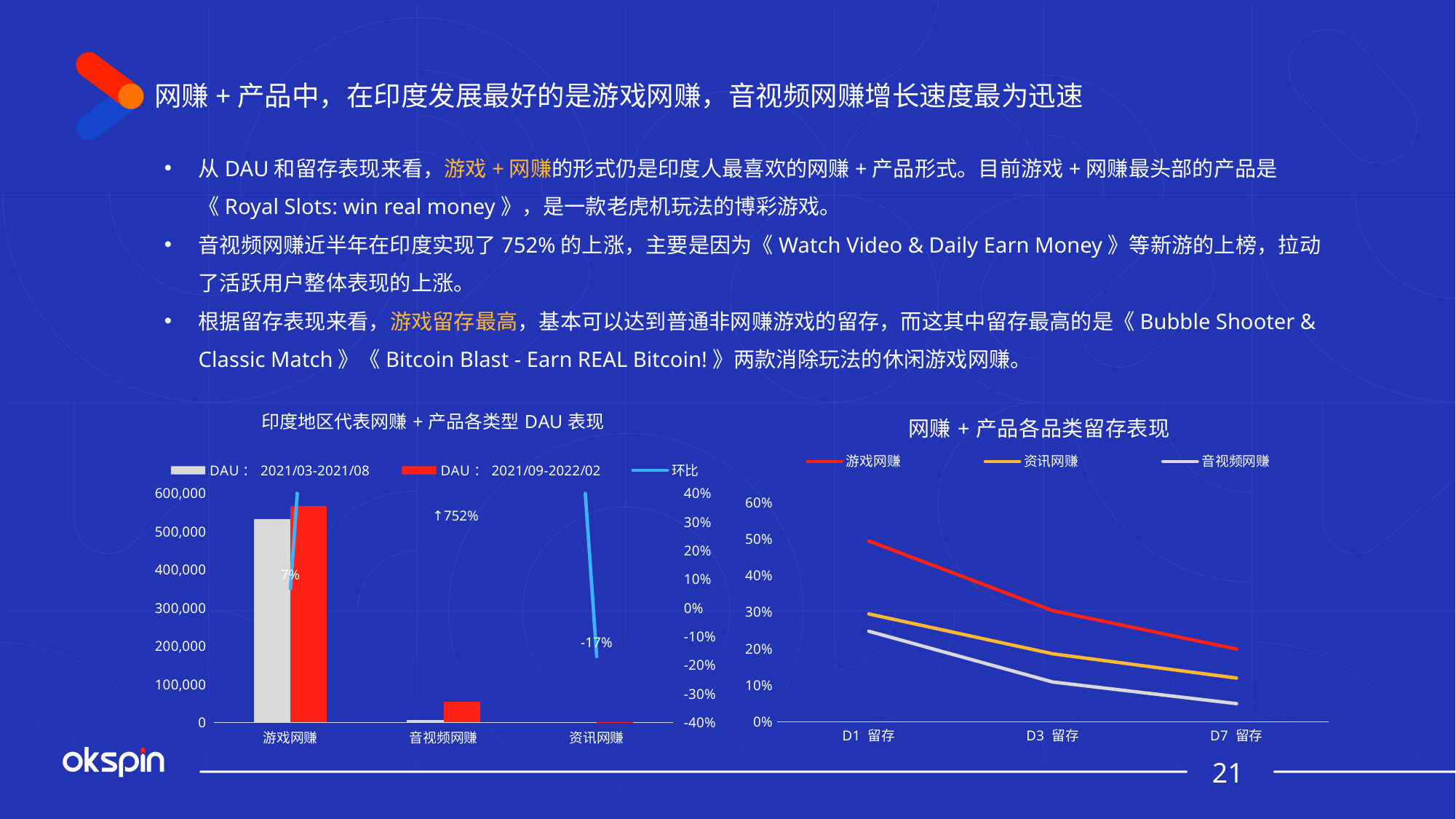
On the chart titled 印度地区代表网赚 + 产品各类型 DAU 表现, is the DAU 2021/09-2022/02 value for 游戏网赚 greater or less than 500,000? greater On the chart titled 网赚 + 产品各品类留存表现, do the values for 游戏网赚 rise or fall from D1 留存 to D7 留存? fall On the chart titled 印度地区代表网赚 + 产品各类型 DAU 表现, which category has the highest 环比 value? 音视频网赚 On the chart titled 印度地区代表网赚 + 产品各类型 DAU 表现, is the DAU 2021/09-2022/02 value for 音视频网赚 greater or less than 100,000? less On the chart titled 网赚 + 产品各品类留存表现, is the value for 音视频网赚 at D7 留存 greater or less than 10%? less On the chart titled 印度地区代表网赚 + 产品各类型 DAU 表现, how many categories are shown on the x axis? 3 On the chart titled 印度地区代表网赚 + 产品各类型 DAU 表现, what is the 环比 value for 音视频网赚? ↑752% On the chart titled 印度地区代表网赚 + 产品各类型 DAU 表现, how many series does the legend list? 3 On the chart titled 印度地区代表网赚 + 产品各类型 DAU 表现, what is the 环比 value for 资讯网赚? -17% On the chart titled 印度地区代表网赚 + 产品各类型 DAU 表现, what is the 环比 value for 游戏网赚? 7% On the chart titled 网赚 + 产品各品类留存表现, which series has the highest value at D1 留存? 游戏网赚 On the chart titled 印度地区代表网赚 + 产品各类型 DAU 表现, which category has the lowest 环比 value? 资讯网赚